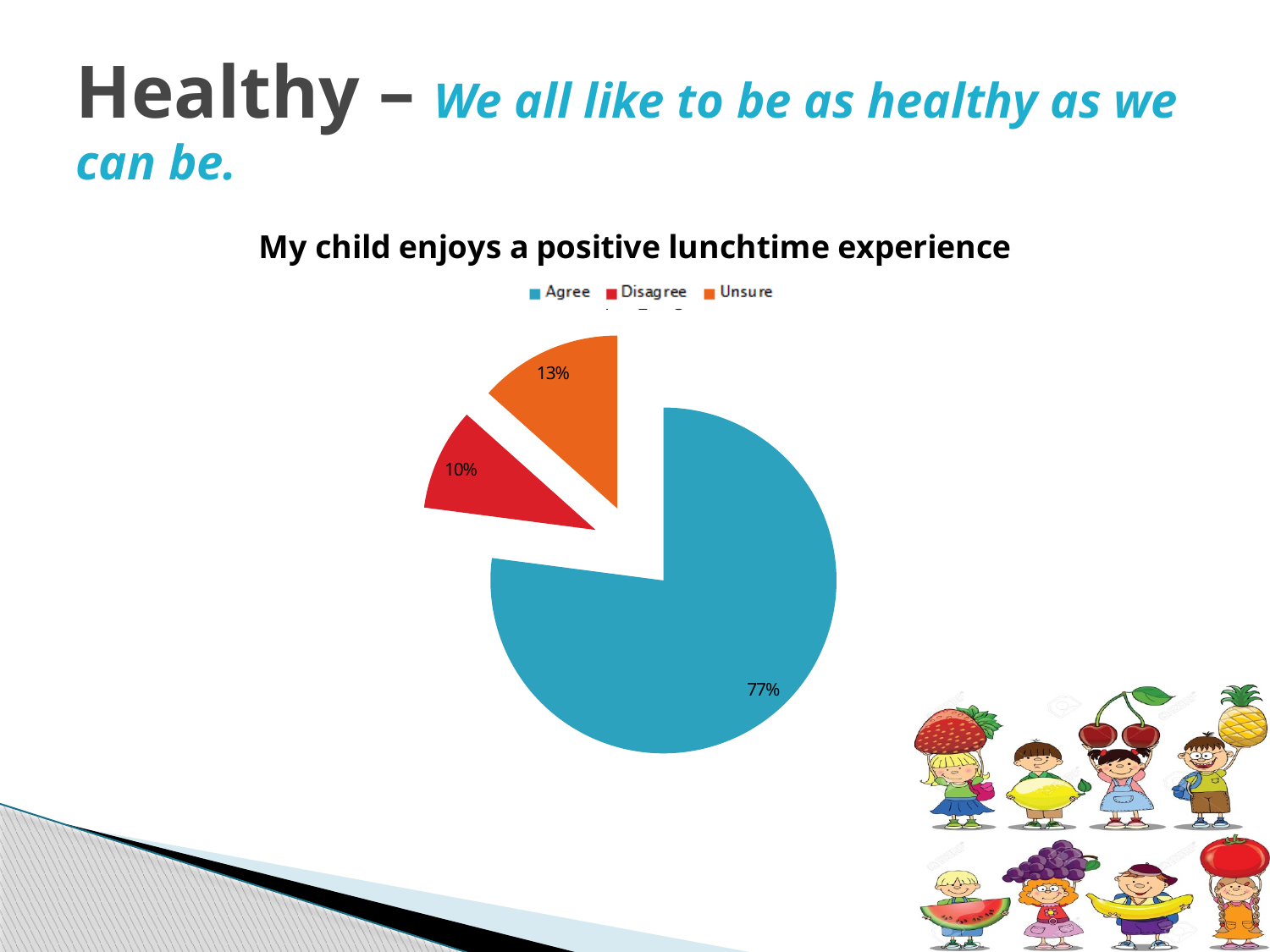
What percentage of respondents disagree? 10% Which is larger, the Unsure share or the Disagree share? Unsure What percentage of respondents agree that their child enjoys a positive lunchtime experience? 77% Which response has the largest share of the pie? Agree What colour is the Agree slice? blue What type of chart is shown on the slide? pie chart Which response has the smallest share of the pie? Disagree What percentage of respondents are unsure? 13% What is the difference in percentage points between Agree and Unsure? 64 What is the title of the chart? My child enjoys a positive lunchtime experience What is the difference in percentage points between Unsure and Disagree? 3 How many categories does the pie chart show? 3